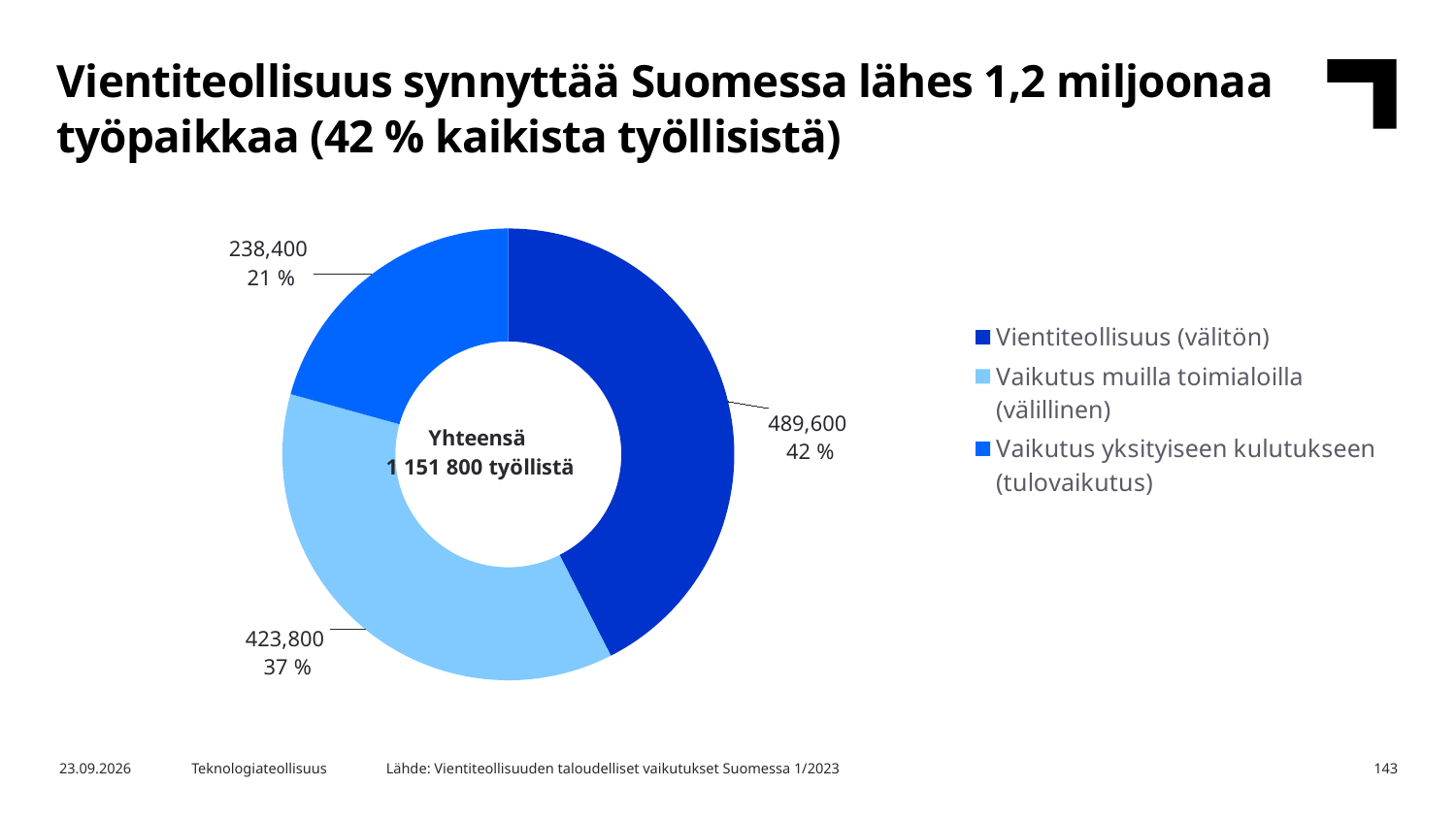
Which category has the largest slice? Vientiteollisuus (välitön) Which category has the smallest slice? Vaikutus yksityiseen kulutukseen (tulovaikutus) What kind of chart is shown on the slide? Doughnut (pie) chart How many entries does the legend list? 3 What share of the doughnut does Vaikutus yksityiseen kulutukseen (tulovaikutus) represent? 21 % How many slices does the doughnut chart have? 3 What share of the doughnut does Vientiteollisuus (välitön) represent? 42 % What is the difference between the values for Vientiteollisuus (välitön) and Vaikutus muilla toimialoilla (välillinen)? 65,800 What is the value for Vaikutus muilla toimialoilla (välillinen)? 423,800 What total is shown in the centre of the doughnut chart? 1 151 800 työllistä What is the value for Vaikutus yksityiseen kulutukseen (tulovaikutus)? 238,400 What is the value for Vientiteollisuus (välitön)? 489,600